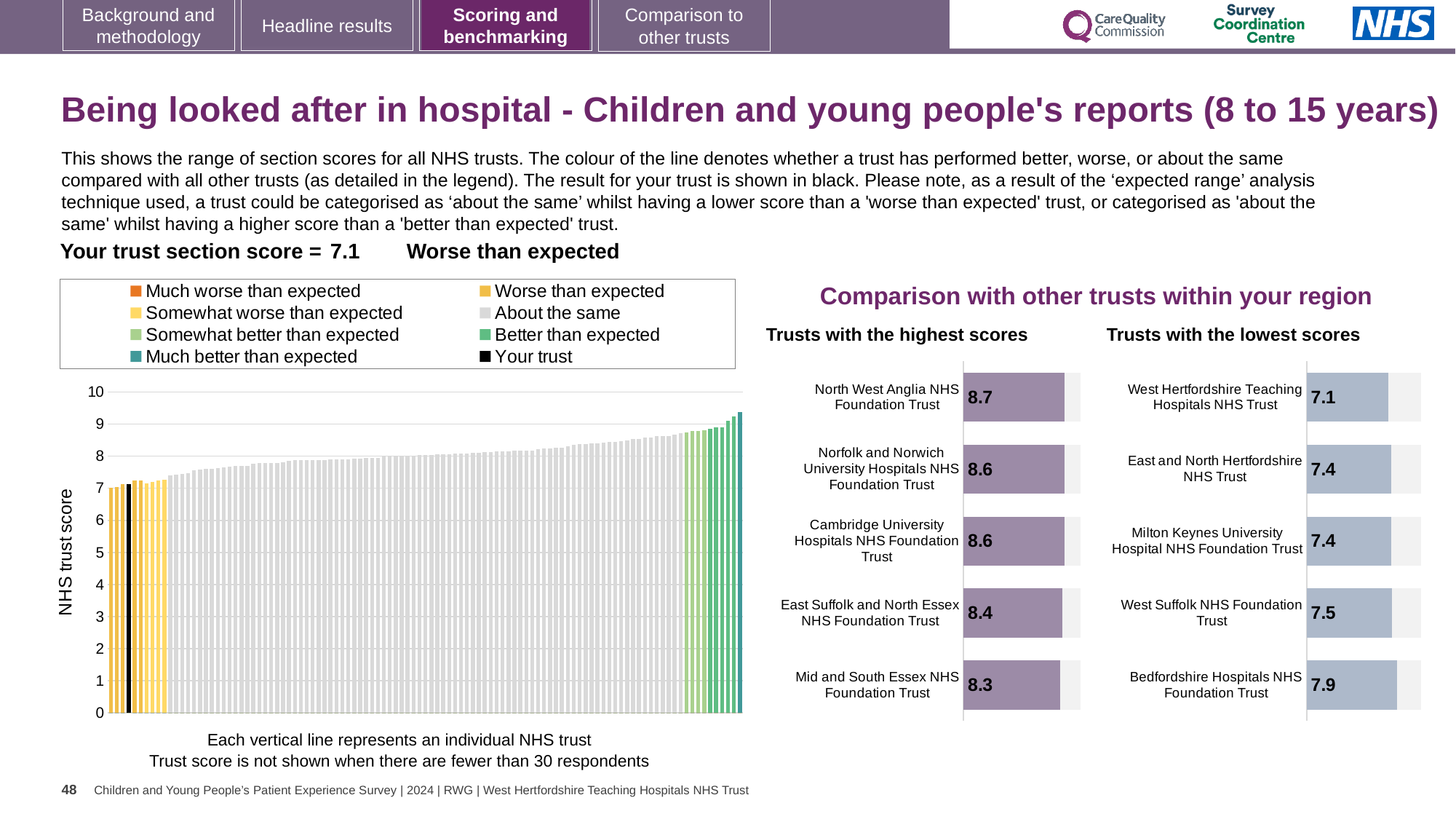
How many trusts are shown in the 'Trusts with the highest scores' chart? 5 In the 'Trusts with the lowest scores' chart, which has the higher score: East and North Hertfordshire NHS Trust or Bedfordshire Hospitals NHS Foundation Trust? Bedfordshire Hospitals NHS Foundation Trust In the 'Trusts with the lowest scores' chart, what is the score for Bedfordshire Hospitals NHS Foundation Trust? 7.9 In the 'Trusts with the highest scores' chart, what is the score for North West Anglia NHS Foundation Trust? 8.7 In the large chart on the left, is the value of the tallest bar greater or less than 9? greater In the 'Trusts with the lowest scores' chart, which trust has the lowest score? West Hertfordshire Teaching Hospitals NHS Trust How many entries does the legend of the large chart on the left list? 8 In the 'Trusts with the highest scores' chart, what is the difference between the scores of North West Anglia NHS Foundation Trust and Mid and South Essex NHS Foundation Trust? 0.4 What is the y-axis label of the large chart on the left? NHS trust score In the 'Trusts with the highest scores' chart, which trust has the lowest score? Mid and South Essex NHS Foundation Trust In the 'Trusts with the lowest scores' chart, what is the score for West Suffolk NHS Foundation Trust? 7.5 What kind of chart is the large chart on the left showing NHS trust scores? Bar chart